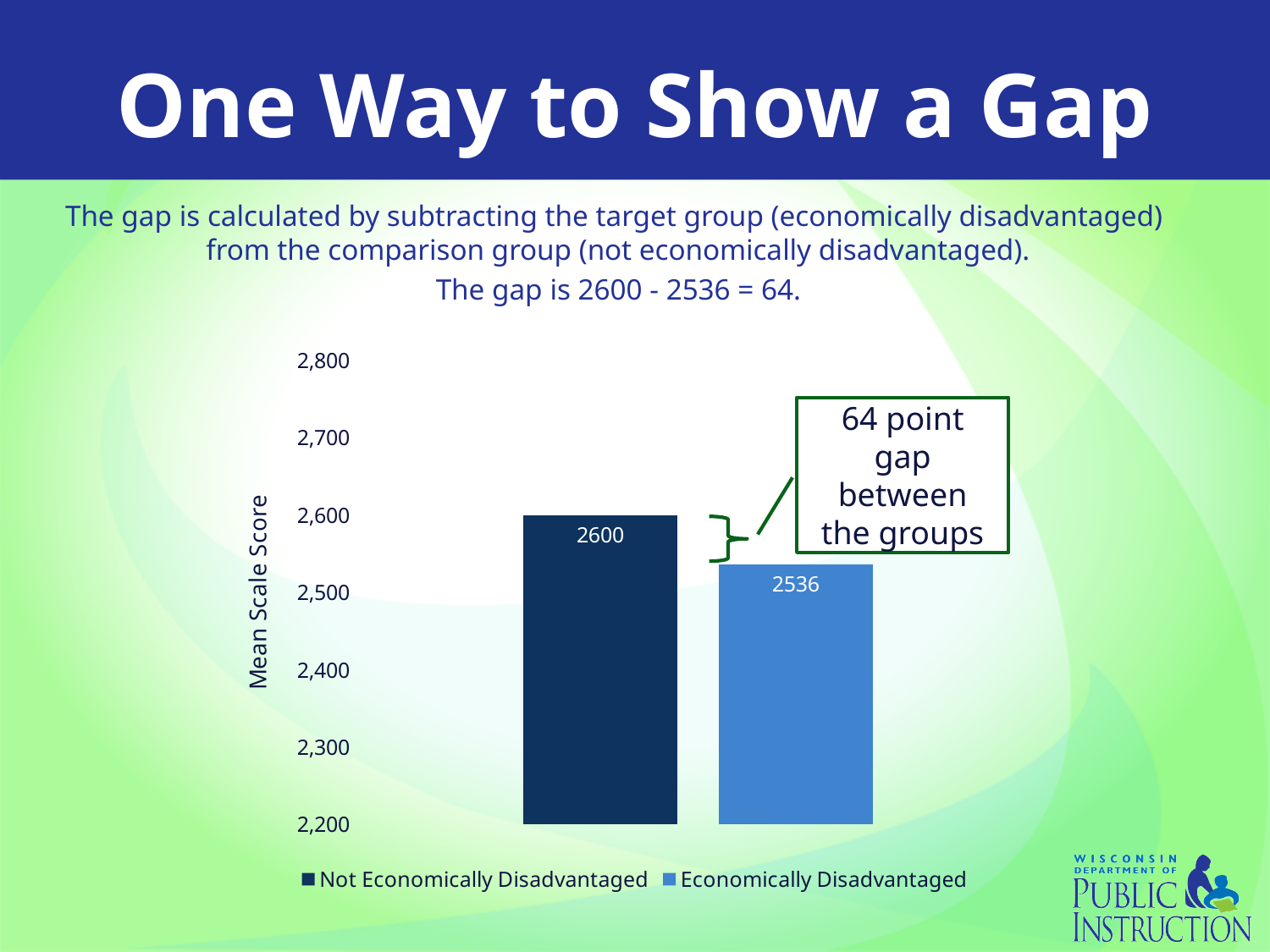
What is the mean scale score for Economically Disadvantaged? 2536 What is the label on the vertical axis of the chart? Mean Scale Score Which group has the lower mean scale score? Economically Disadvantaged What is the highest value shown on the vertical axis? 2,800 Is the value for Not Economically Disadvantaged greater or less than 2,500? greater Is the value for Economically Disadvantaged greater or less than 2,600? less How many series does the legend list? 2 What is the difference between the mean scale scores of the Not Economically Disadvantaged and Economically Disadvantaged groups? 64 What kind of chart is shown on the slide? Bar chart Which group has the higher mean scale score? Not Economically Disadvantaged What is the mean scale score for Not Economically Disadvantaged? 2600 What does the callout box next to the chart say? 64 point gap between the groups